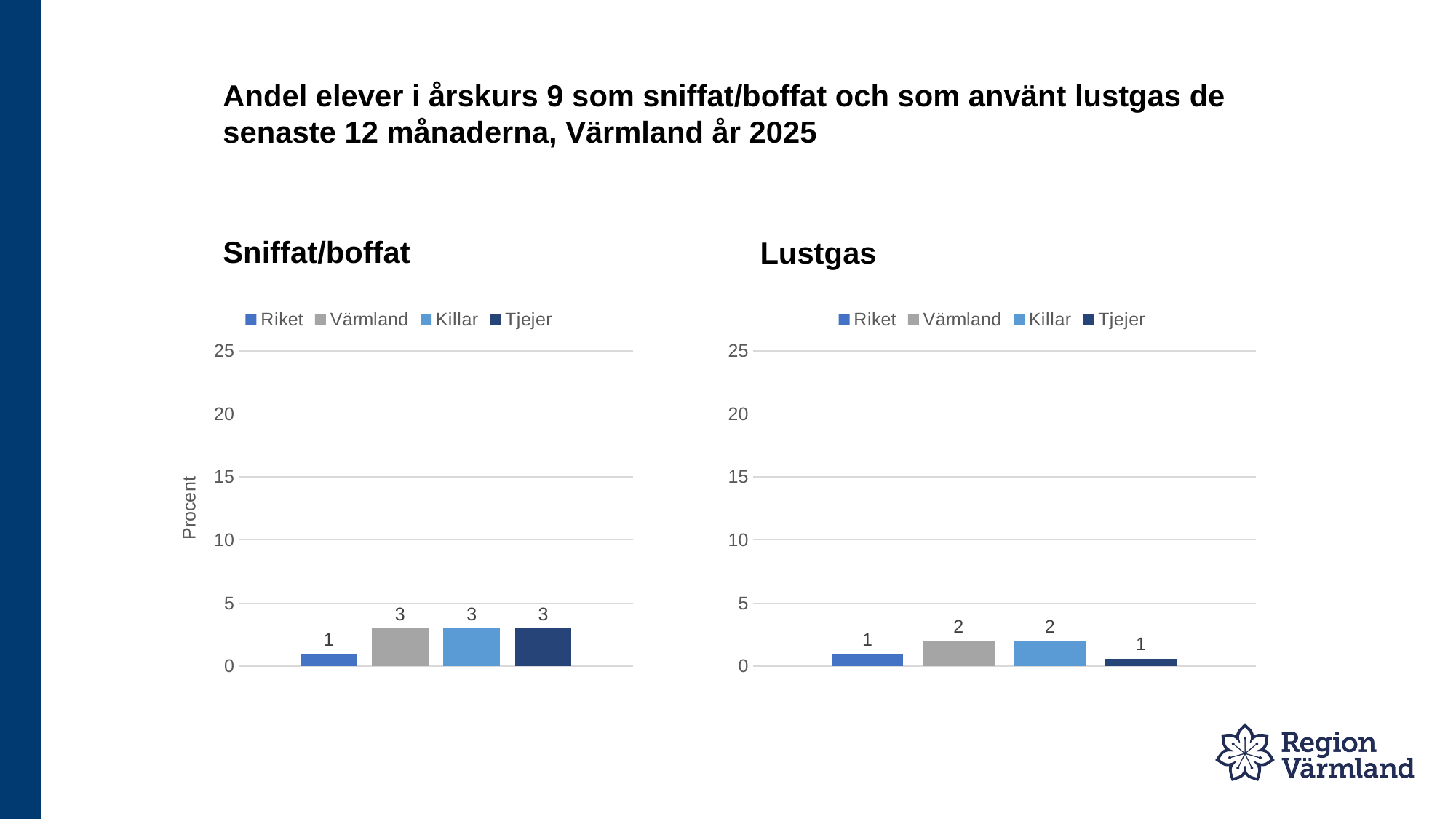
How many series does the legend of the Lustgas chart list? 4 In the Lustgas chart, what is the value for Killar? 2 In the Sniffat/boffat chart, what is the value for Riket? 1 In the Sniffat/boffat chart, which series has the lowest value? Riket What is the label on the vertical axis of the Sniffat/boffat chart? Procent In the Lustgas chart, which is larger, the value for Killar or the value for Riket? Killar In the Lustgas chart, what is the difference between the values for Värmland and Riket? 1 In the Lustgas chart, what is the value for Riket? 1 What kind of chart is the Sniffat/boffat chart? bar chart In the Sniffat/boffat chart, what is the difference between the values for Värmland and Riket? 2 In the Sniffat/boffat chart, what is the value for Värmland? 3 In the Sniffat/boffat chart, is the value for Tjejer greater or less than 5? less